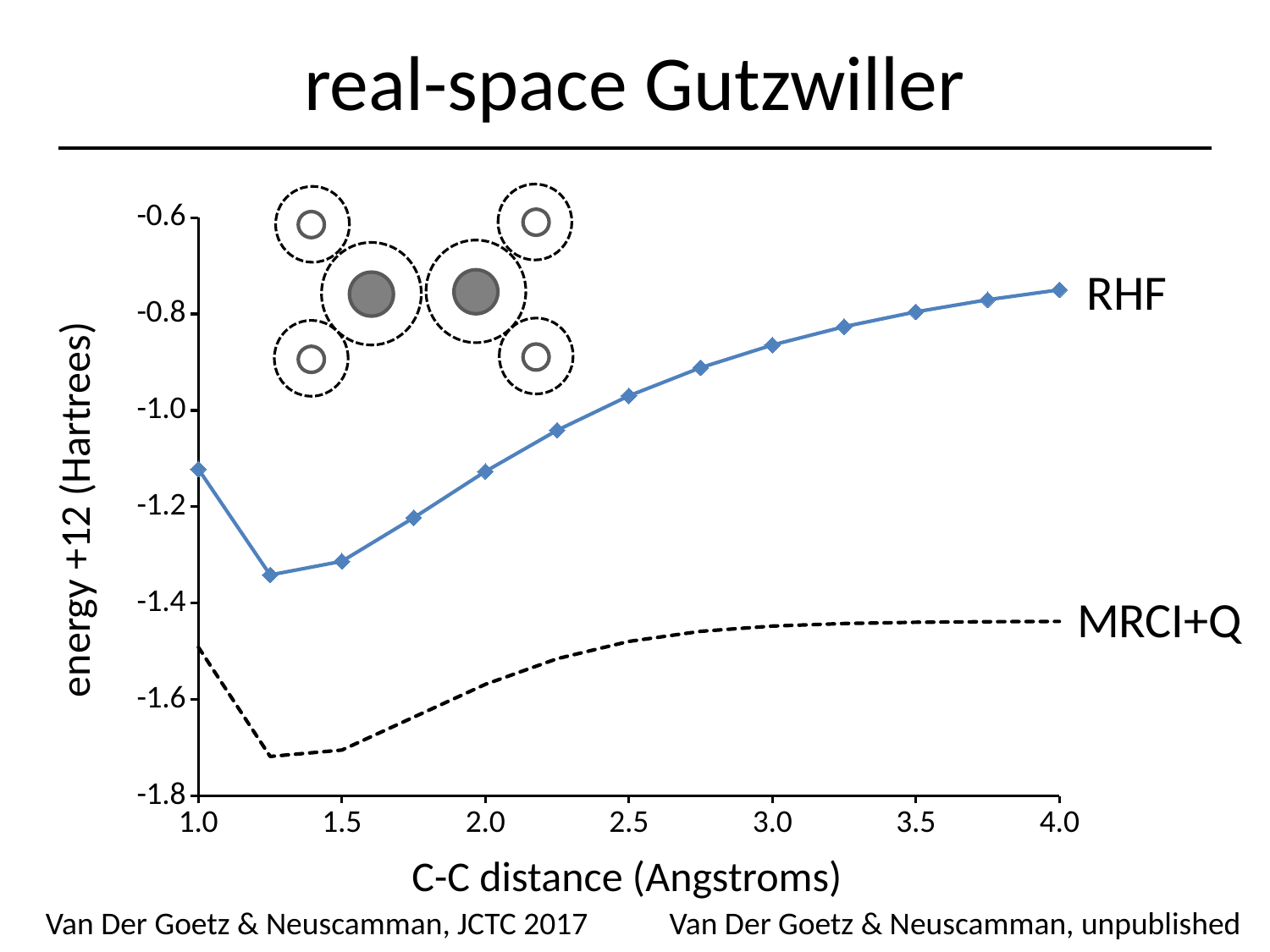
How many data series are plotted on the chart? 2 What kind of chart is shown on the slide? line chart Is the RHF energy at a C-C distance of 1.0 greater or less than -1.0? less At a C-C distance of 2.0, which series has the higher energy, RHF or MRCI+Q? RHF What is the label of the x axis? C-C distance (Angstroms) Is the MRCI+Q energy at a C-C distance of 4.0 greater or less than -1.6? greater Is the MRCI+Q energy at a C-C distance of 1.25 greater or less than -1.6? less Does the RHF energy rise or fall as the C-C distance increases from 1.25 to 4.0? rise At which C-C distance does the RHF series reach its highest energy? 4.0 How many data points (markers) does the RHF series have? 13 At which C-C distance does the RHF series reach its lowest energy? 1.25